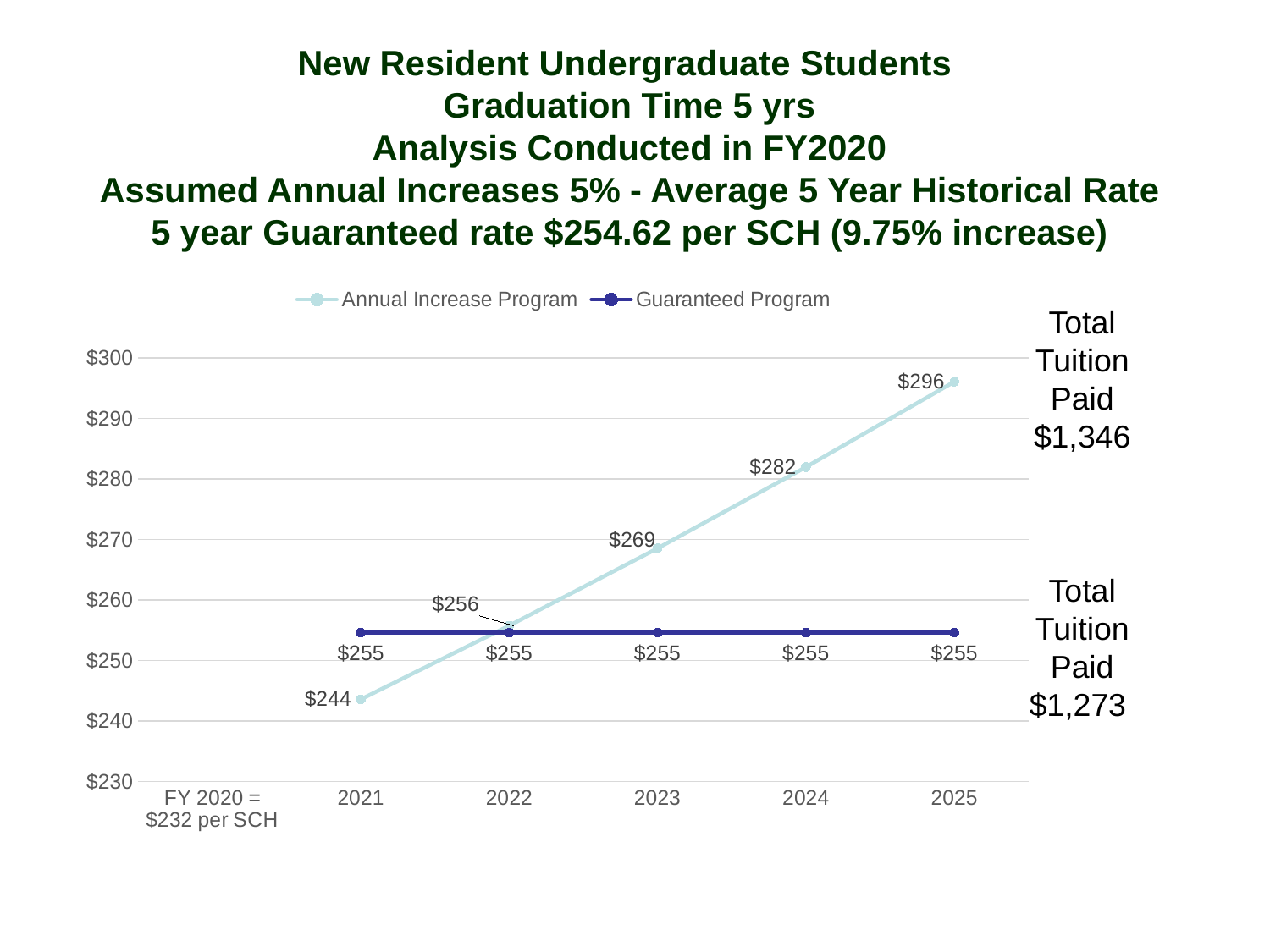
How many years are plotted on the x axis of the chart? 5 What is the difference between the Annual Increase Program and the Guaranteed Program in 2024? $27 What is the value of the Annual Increase Program in 2025? $296 What kind of chart is shown on the slide? Line chart How many series does the legend list? 2 In which year is the Annual Increase Program value lowest? 2021 Which series has the larger value in 2021, Annual Increase Program or Guaranteed Program? Guaranteed Program What is the value of the Guaranteed Program in 2023? $255 In which year is the Annual Increase Program value highest? 2025 What is the value of the Annual Increase Program in 2023? $269 Does the Annual Increase Program rise or fall from 2021 to 2025? Rise What is the value of the Annual Increase Program in 2021? $244